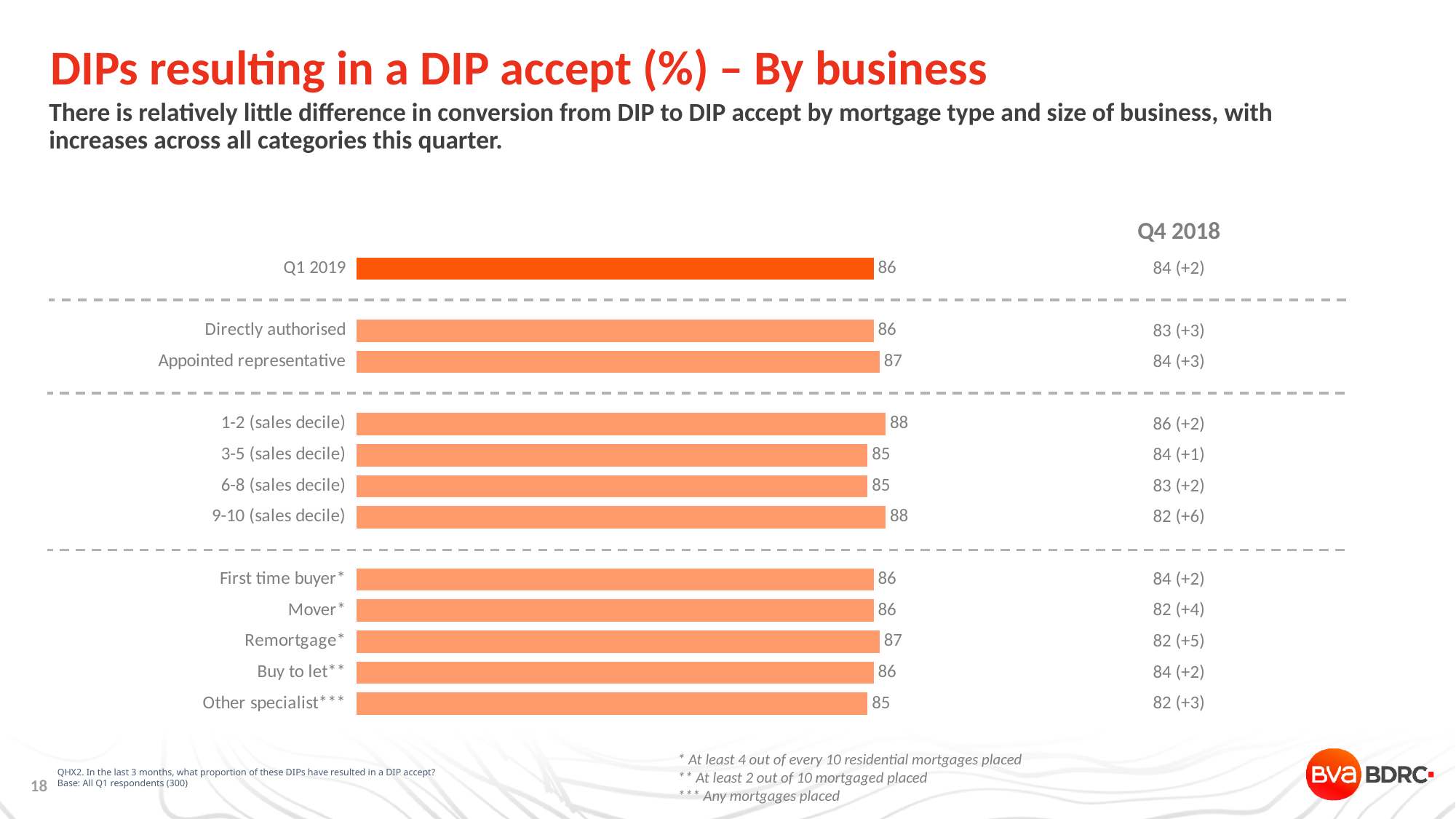
How many bars are plotted on the chart? 12 What is the value for Appointed representative? 87 What is the value for Other specialist? 85 What is the value for the Q1 2019 total bar? 86 What is the difference between the values for 1-2 (sales decile) and 3-5 (sales decile)? 3 Which has the larger value, 1-2 (sales decile) or 6-8 (sales decile)? 1-2 (sales decile) What is the value for 9-10 (sales decile)? 88 What is the difference between the values for Remortgage and Other specialist? 2 What kind of chart is shown on the slide? Bar chart Which has the larger value, Appointed representative or Directly authorised? Appointed representative Which category had the largest increase from Q4 2018 according to the figures in brackets? 9-10 (sales decile) What was the Q4 2018 value shown for Mover? 82 (+4)